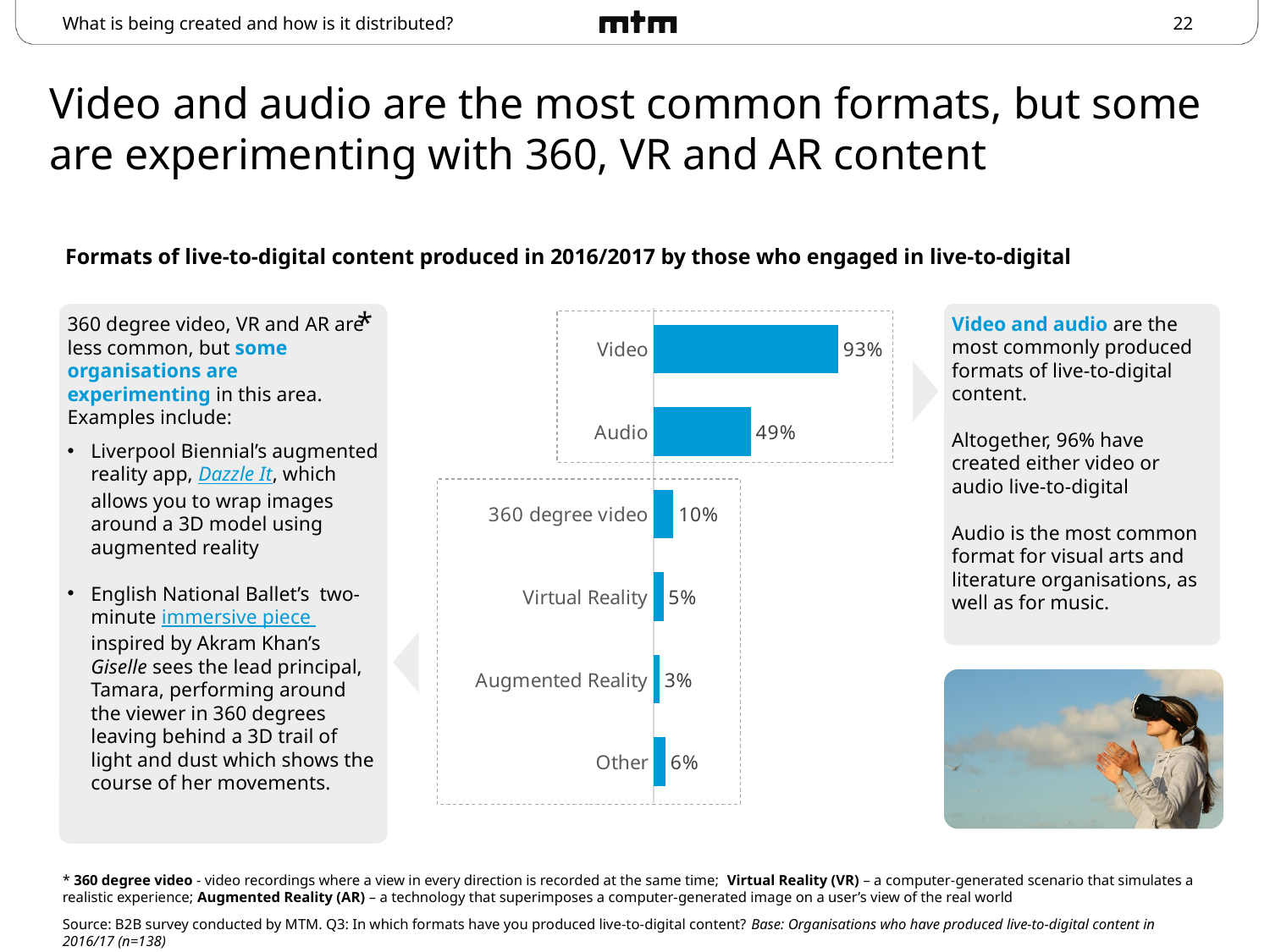
What percentage of organisations produced audio content? 49% What kind of chart is shown on the slide? Bar chart What is the difference between the values for 360 degree video and Virtual Reality? 5% What is the value for Augmented Reality? 3% What percentage of organisations produced video content? 93% How many format categories are shown in the chart? 6 Which is larger, the value for Virtual Reality or the value for Other? Other What is the value for 360 degree video? 10% What is the title of the chart? Formats of live-to-digital content produced in 2016/2017 by those who engaged in live-to-digital What is the difference between the values for Video and Audio? 44% Which format has the lowest value in the chart? Augmented Reality Which format has the highest value in the chart? Video